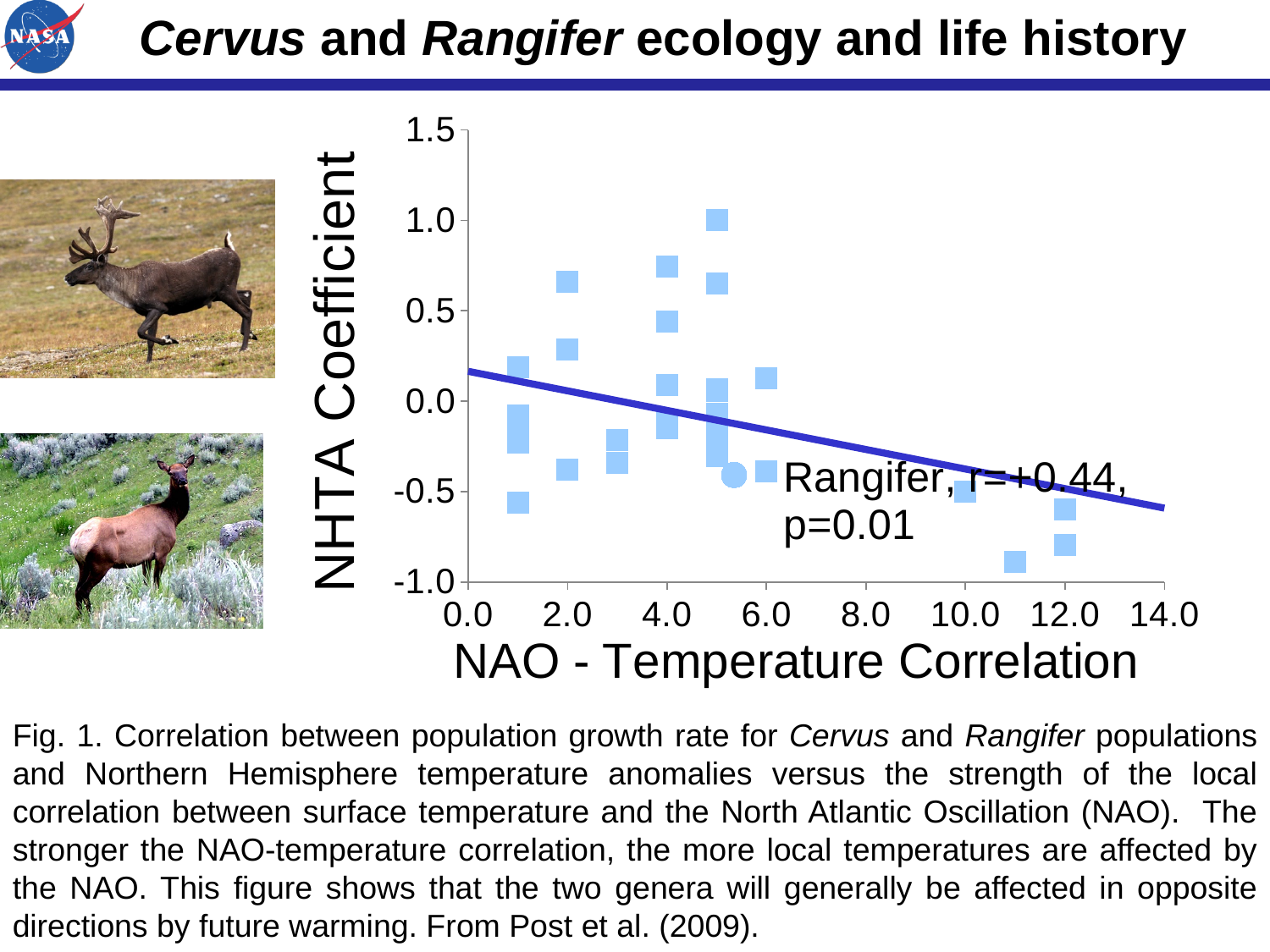
What is the title of the vertical axis of the chart? NHTA Coefficient Where the trend line meets the left edge of the plot at 0.0 on the x axis, is its value greater or less than 0.5? less Does the fitted trend line rise or fall as the NAO - Temperature Correlation increases along the x axis? fall What p-value is printed on the chart for Rangifer? 0.01 Is the highest plotted point on the chart greater or less than 0.5 on the NHTA Coefficient axis? greater Where the trend line reaches 14.0 on the x axis, is its value greater or less than 0.0? less What correlation coefficient r is printed on the chart for Rangifer? +0.44 What is the title of the horizontal axis of the chart? NAO - Temperature Correlation What kind of chart is shown on the slide? scatter chart